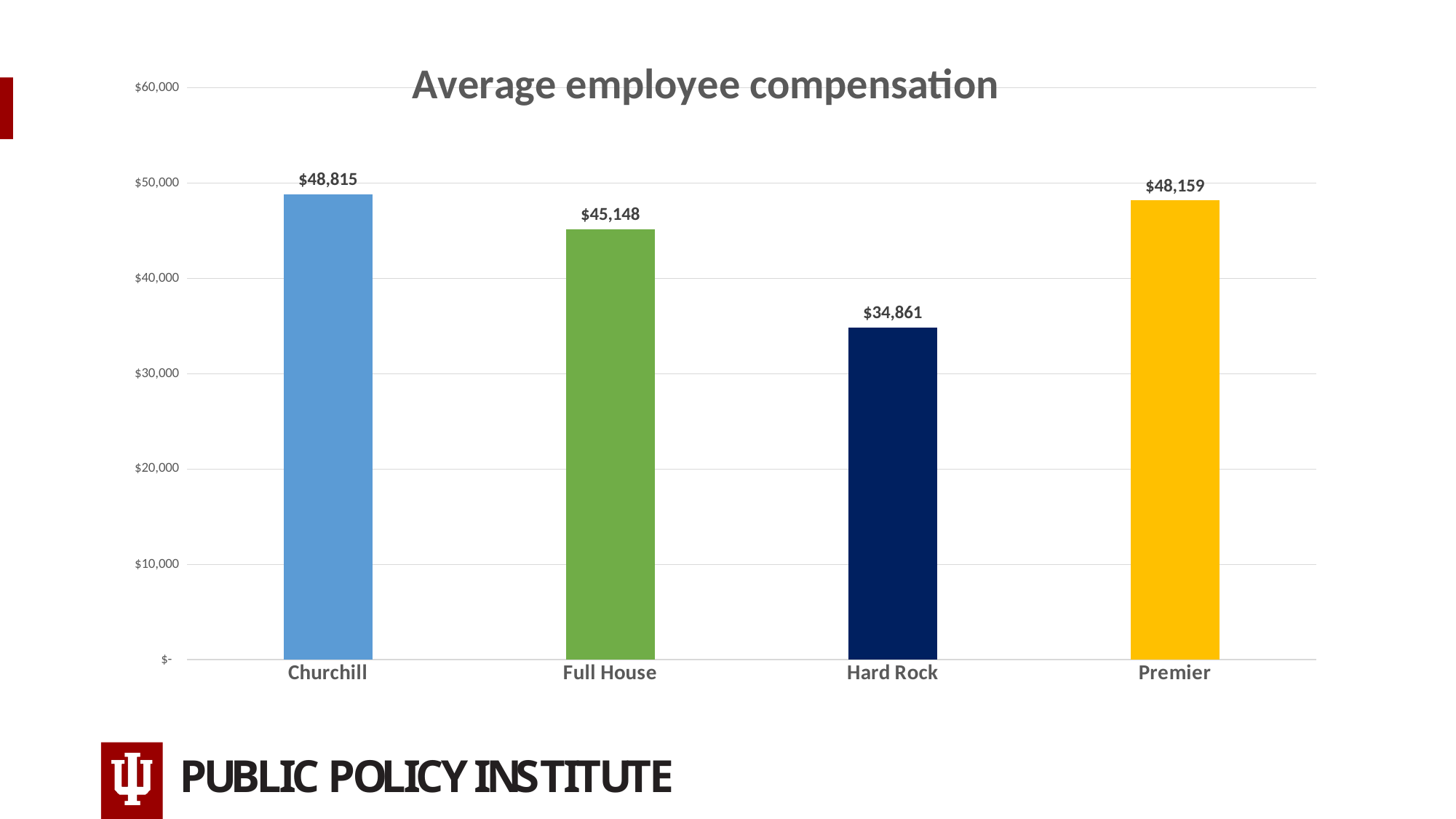
What is the average employee compensation for Churchill? $48,815 What is the difference between the average employee compensation for Premier and Full House? $3,011 Which category has the lowest average employee compensation? Hard Rock How many categories are shown in the chart? 4 What kind of chart is shown on the slide? Bar chart Which has a higher average employee compensation, Full House or Hard Rock? Full House What is the average employee compensation for Full House? $45,148 Is the value for Hard Rock greater or less than $40,000? less What is the average employee compensation for Hard Rock? $34,861 What is the difference between the average employee compensation for Churchill and Hard Rock? $13,954 What is the average employee compensation for Premier? $48,159 Which category has the highest average employee compensation? Churchill